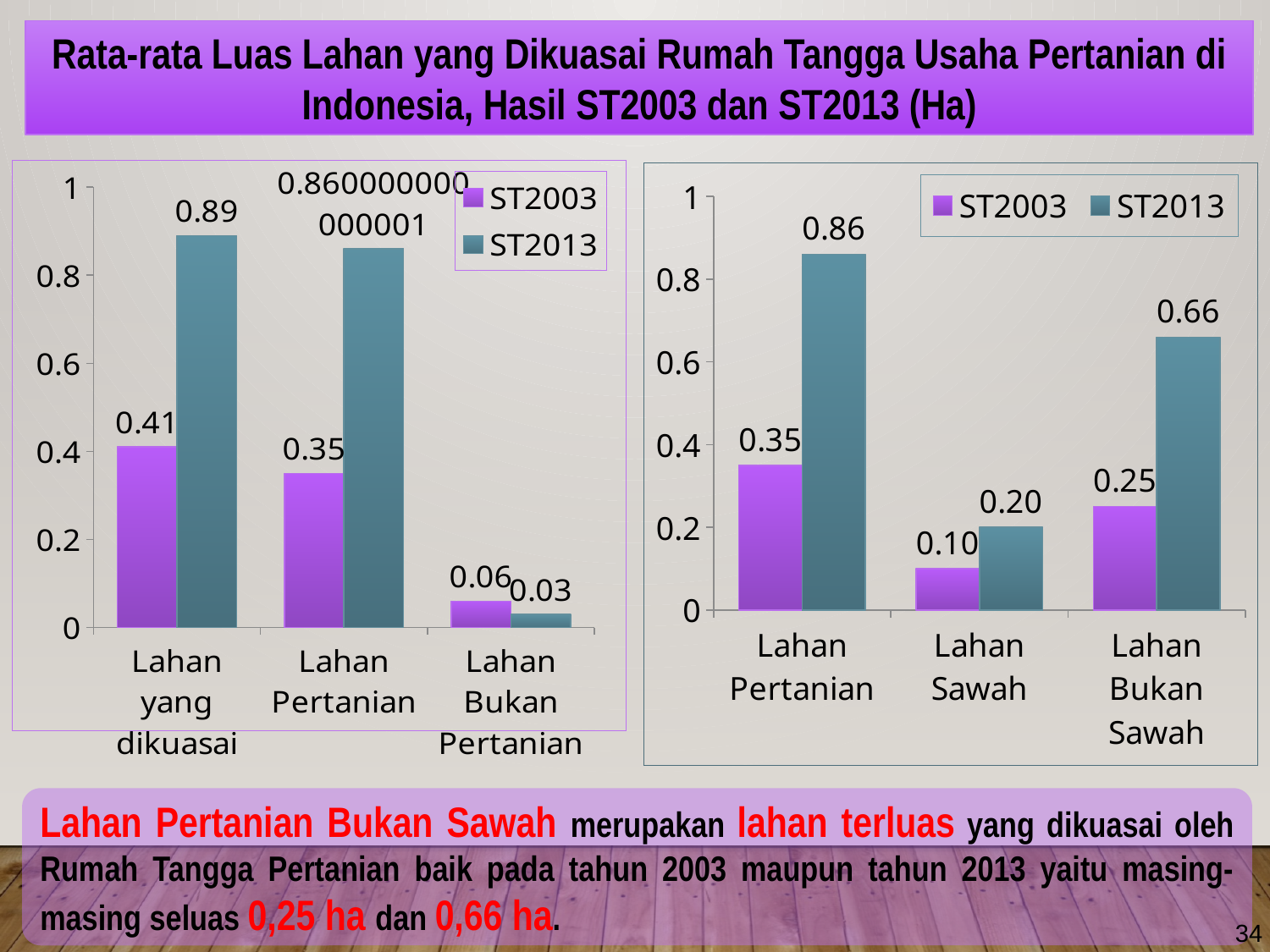
In the left chart, which category has the lowest ST2013 value? Lahan Bukan Pertanian How many series does the legend of the right chart list? 2 In the left chart, what is the difference between the ST2013 and ST2003 values for Lahan yang dikuasai? 0.48 In the right chart, what is the difference between the ST2013 and ST2003 values for Lahan Bukan Sawah? 0.41 In the right chart, what is the ST2013 value for Lahan Bukan Sawah? 0.66 In the left chart, what is the ST2013 value for Lahan yang dikuasai? 0.89 In the right chart, which is larger: the ST2003 value for Lahan Sawah or the ST2003 value for Lahan Bukan Sawah? Lahan Bukan Sawah In the right chart, which category has the highest ST2013 value? Lahan Pertanian In the left chart, what is the ST2003 value for Lahan yang dikuasai? 0.41 In the left chart, what is the ST2003 value for Lahan Bukan Pertanian? 0.06 In the right chart, what is the ST2003 value for Lahan Sawah? 0.10 What type of chart is the right chart? Bar chart